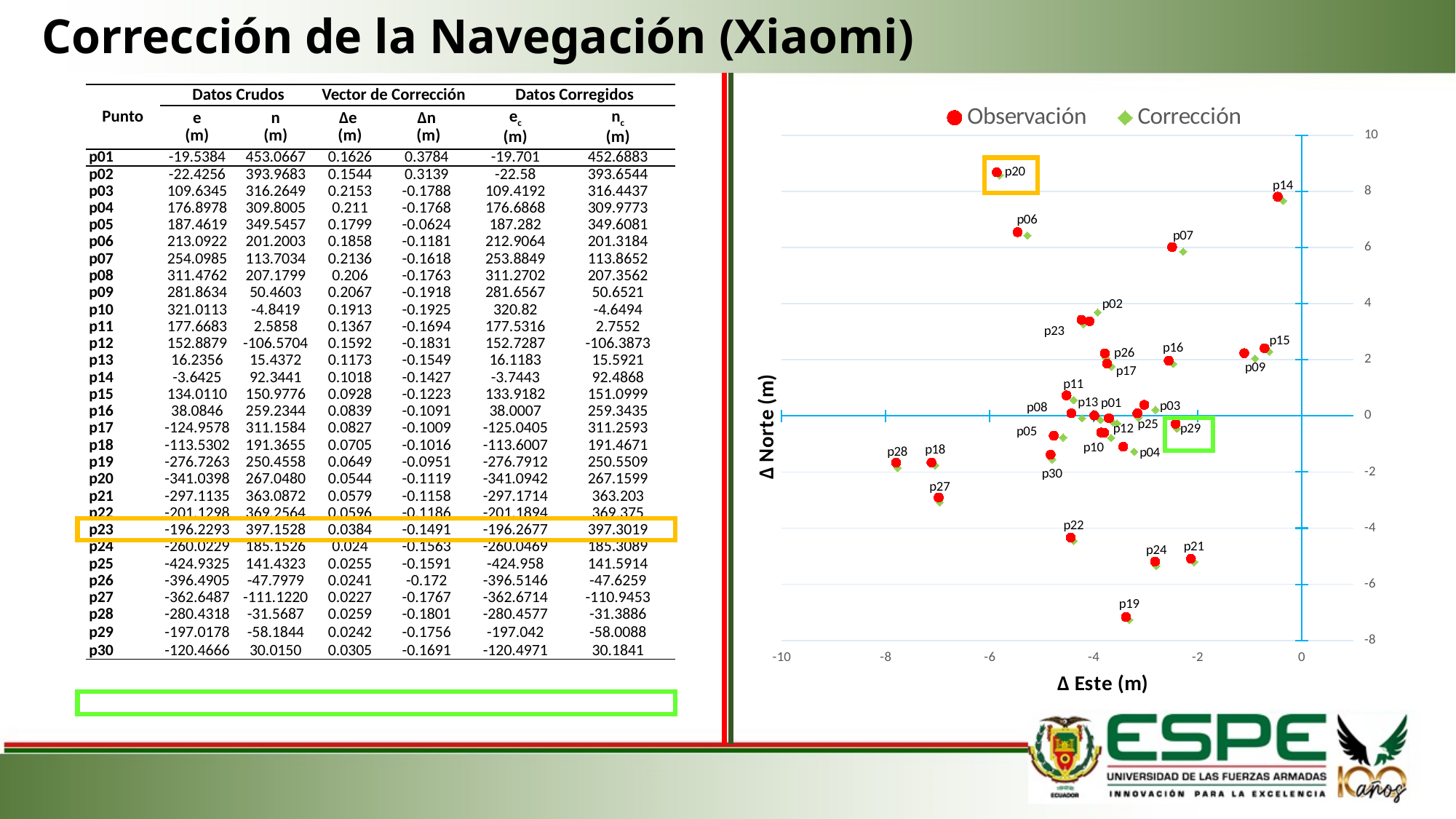
What are the two series named in the chart legend? Observación and Corrección Which labelled point has the lowest Δ Norte value in the chart? p19 Which labelled point has the highest Δ Norte value in the chart? p20 Is the Δ Norte value for p06 greater or less than 6? greater Which labelled point has the lowest Δ Este value (furthest left) in the chart? p28 What is the title of the horizontal axis of the chart? Δ Este (m) What kind of chart is shown on the right side of the slide? scatter chart Is the Δ Este value for p28 greater or less than -6? less Is the Δ Norte value for p20 greater or less than 8? greater How many series does the chart legend list? 2 Which point has a higher Δ Norte value, p20 or p14? p20